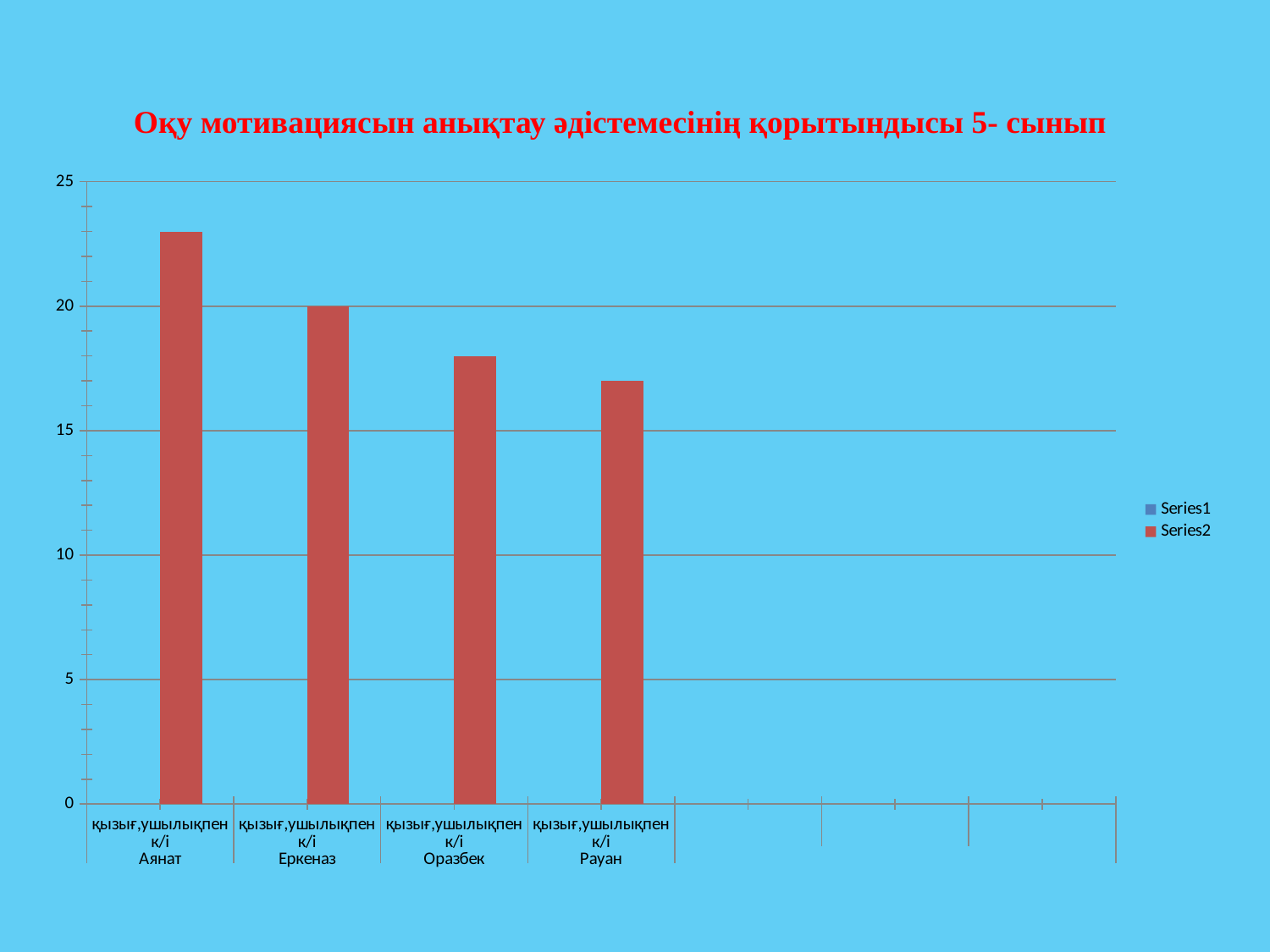
How many bars (categories) are plotted in the chart? 4 Which student has the lowest bar in the chart? Рауан What kind of chart is shown on the slide? bar chart What is the value of the bar for Еркеназ? 20 Is the value for Оразбек greater or less than 20? less Is the value for Рауан greater or less than 15? greater How many series does the legend list? 2 Which student has the highest bar in the chart? Аянат What is the title of the chart? Оқу мотивациясын анықтау әдістемесінің қорытындысы 5- сынып Is the value for Аянат greater or less than 20? greater Do the bar values rise or fall from left to right along the x axis? fall Which bar is taller, Аянат or Еркеназ? Аянат